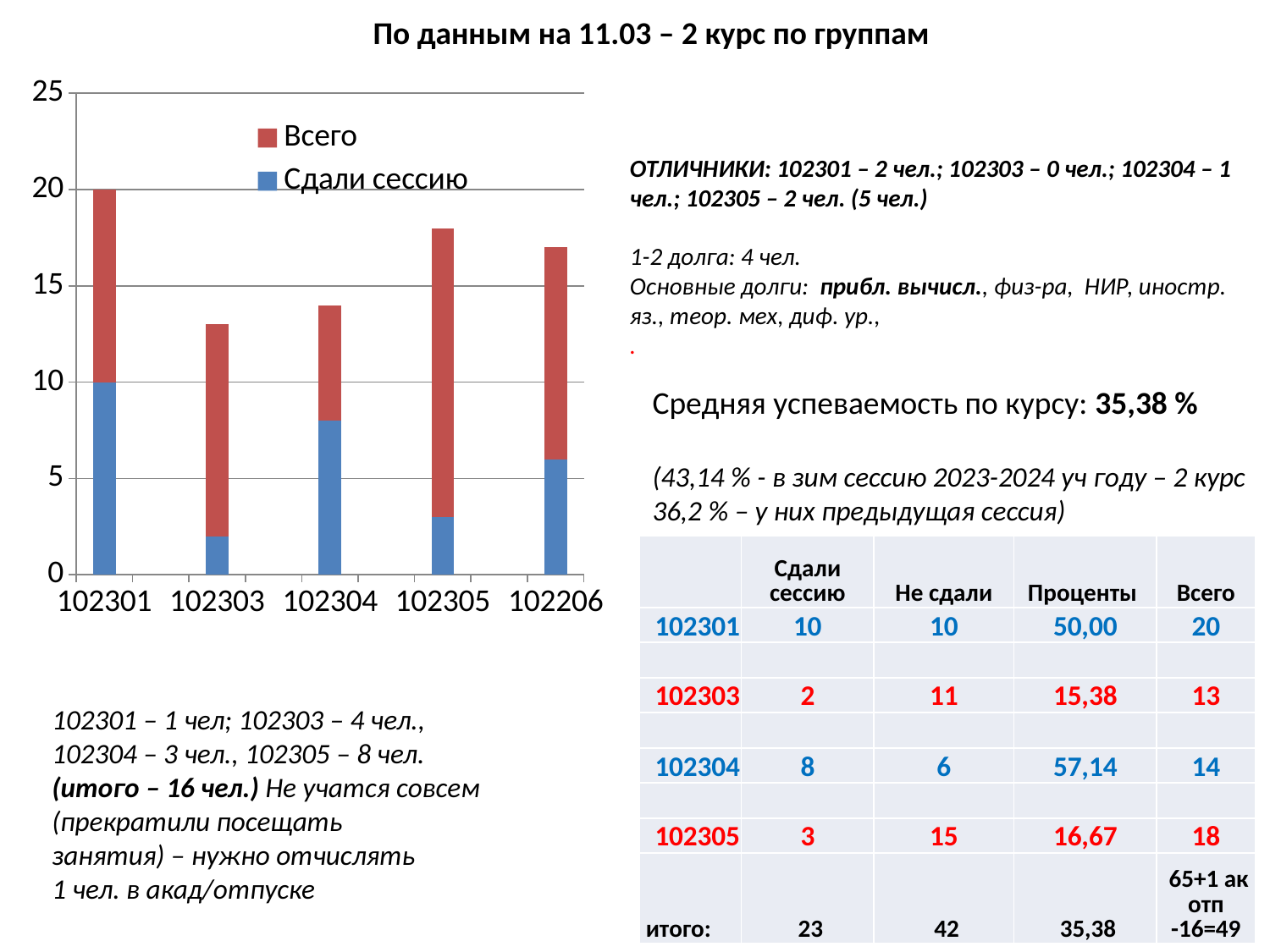
How many groups (categories) are shown on the x axis of the chart? 5 What kind of chart is shown on the slide? bar chart How many series does the chart legend list? 2 What is the value of 'Сдали сессию' for group 102301 in the chart? 10 What are the two entries in the chart legend? Всего, Сдали сессию Is the 'Сдали сессию' value for group 102206 greater or less than 5? greater Which group has the highest 'Сдали сессию' value in the chart? 102301 Which group has the larger 'Всего' value, 102305 or 102304? 102305